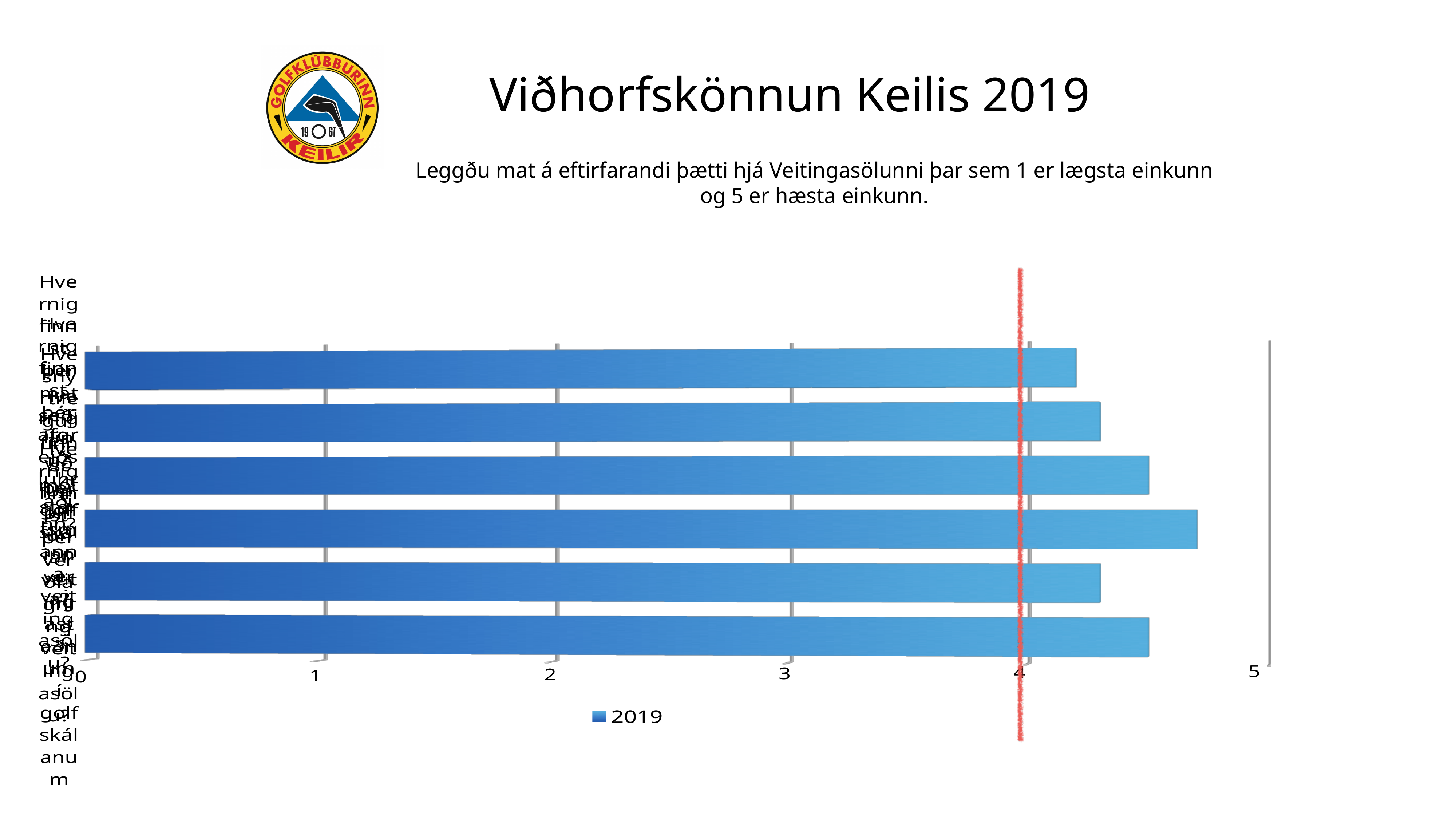
What is the highest value shown on the x axis? 5 What is the legend entry of the chart? 2019 Which is larger, the value of the third bar from the top or the value of the fifth bar from the top? the third bar from the top Which is larger, the value of the fourth bar from the top or the value of the top bar? the fourth bar from the top Is the value for the fourth bar from the top greater or less than 4? greater How many bars does the chart contain? 6 What is the title of the slide containing the chart? Viðhorfskönnun Keilis 2019 Is the value for the top bar greater or less than 4? greater Is the value for the bottom bar greater or less than 5? less What kind of chart is shown on the slide? bar chart How many series does the legend list? 1 Which bar has the highest value? the fourth bar from the top